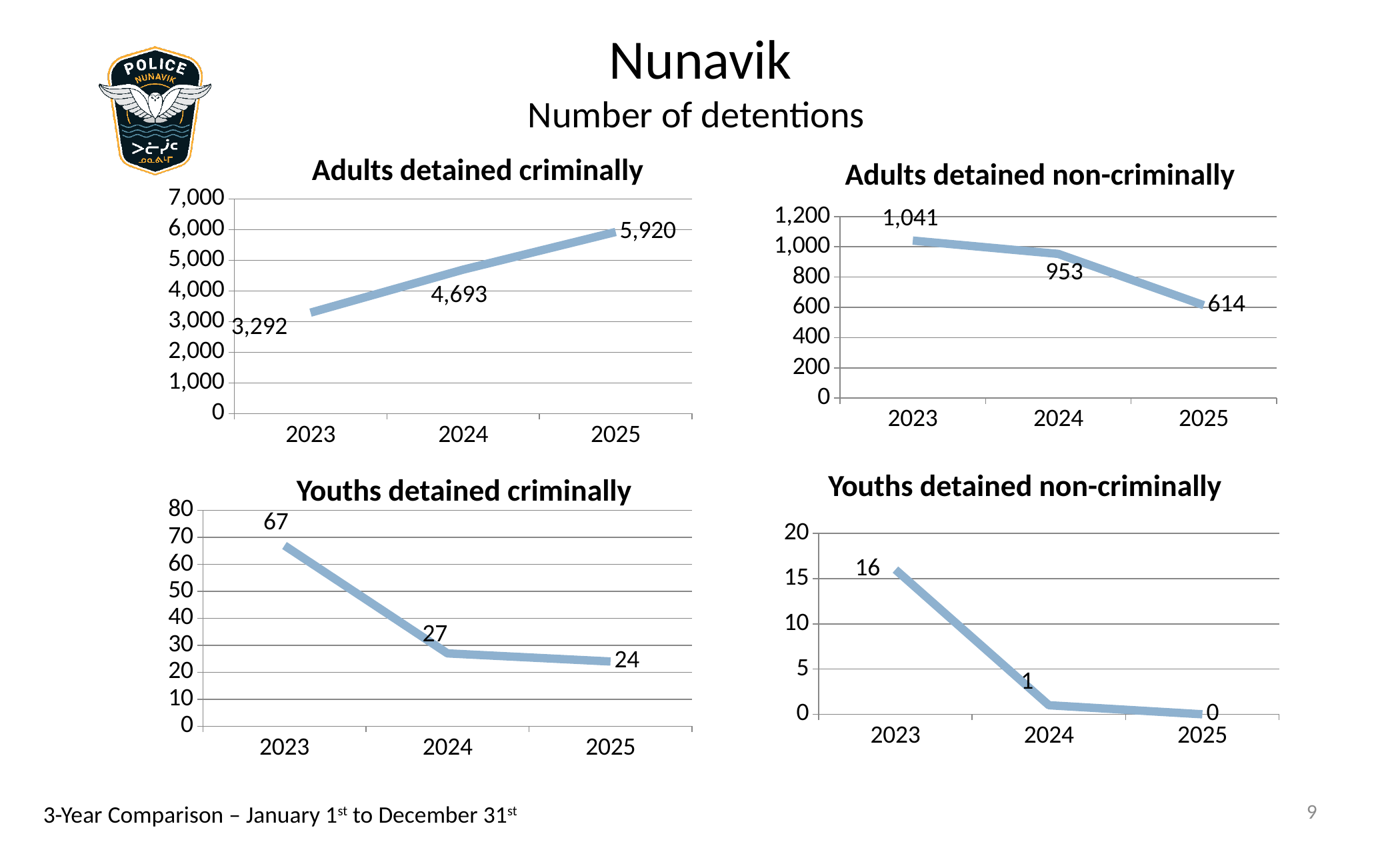
What kind of chart is the 'Youths detained criminally' chart? line chart In the 'Adults detained non-criminally' chart, which year has the lowest value? 2025 In the 'Adults detained non-criminally' chart, which is larger, the value for 2023 or the value for 2025? 2023 In the 'Adults detained criminally' chart, what is the difference between the 2025 and 2023 values? 2,628 In the 'Youths detained criminally' chart, what is the value for 2023? 67 In the 'Adults detained criminally' chart, do the values rise or fall from 2023 to 2025? rise How many years are plotted in the 'Youths detained non-criminally' chart? 3 In the 'Youths detained criminally' chart, what is the difference between the 2023 and 2024 values? 40 In the 'Adults detained criminally' chart, what is the value for 2025? 5,920 In the 'Adults detained criminally' chart, which year has the highest value? 2025 In the 'Adults detained non-criminally' chart, what is the value for 2024? 953 In the 'Youths detained non-criminally' chart, what is the value for 2025? 0